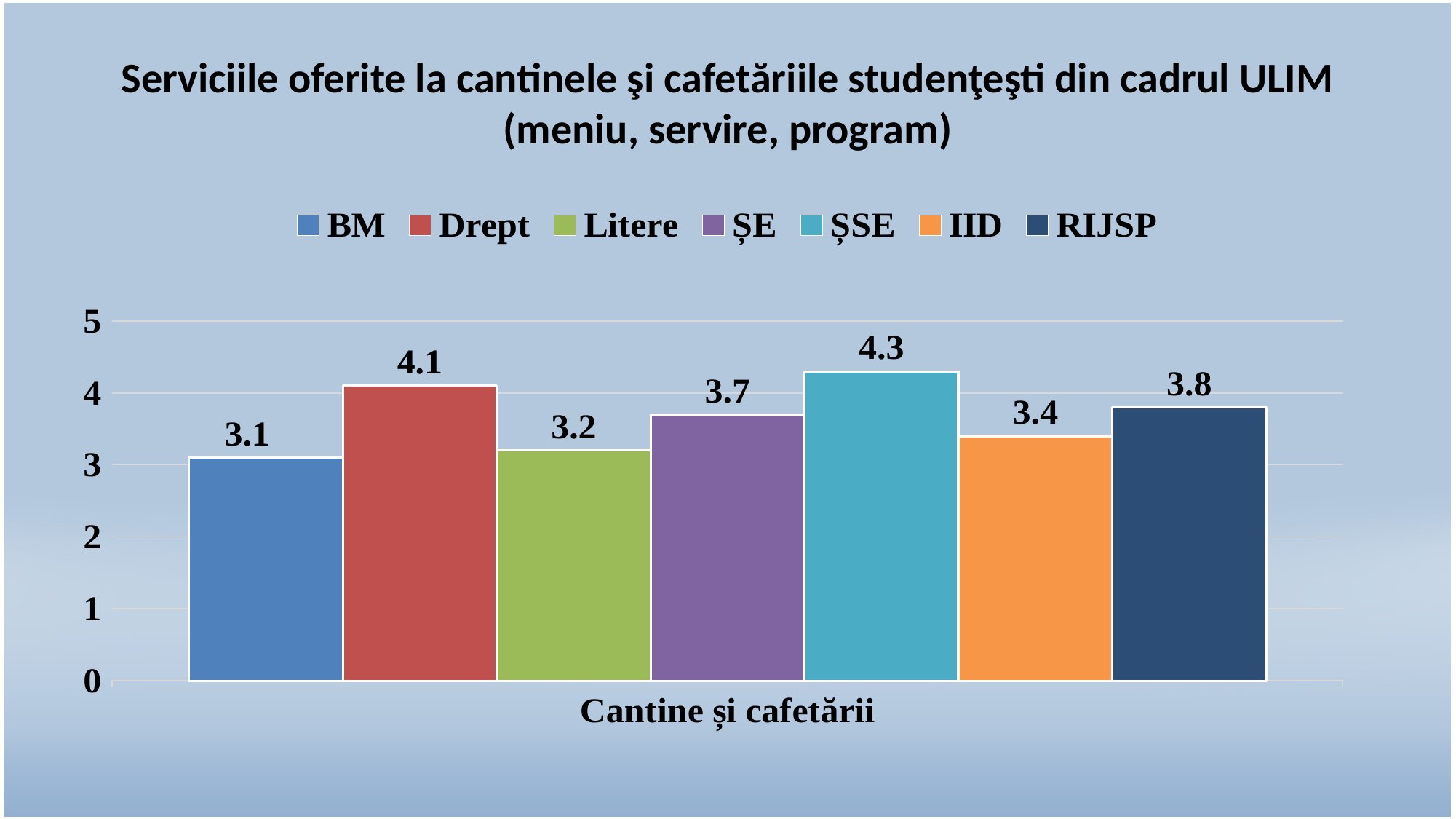
Is the value for Drept greater or less than 4? greater Which series has the highest value? ȘSE What is the label on the horizontal axis of the chart? Cantine și cafetării How many series does the legend list? 7 What is the value for IID? 3.4 What kind of chart is shown on the slide? bar chart What is the value for ȘE? 3.7 What is the value for Drept? 4.1 Which is larger, the value for RIJSP or the value for Litere? RIJSP What is the difference between the values for ȘSE and BM? 1.2 Which series has the lowest value? BM How many bars are plotted in the chart? 7